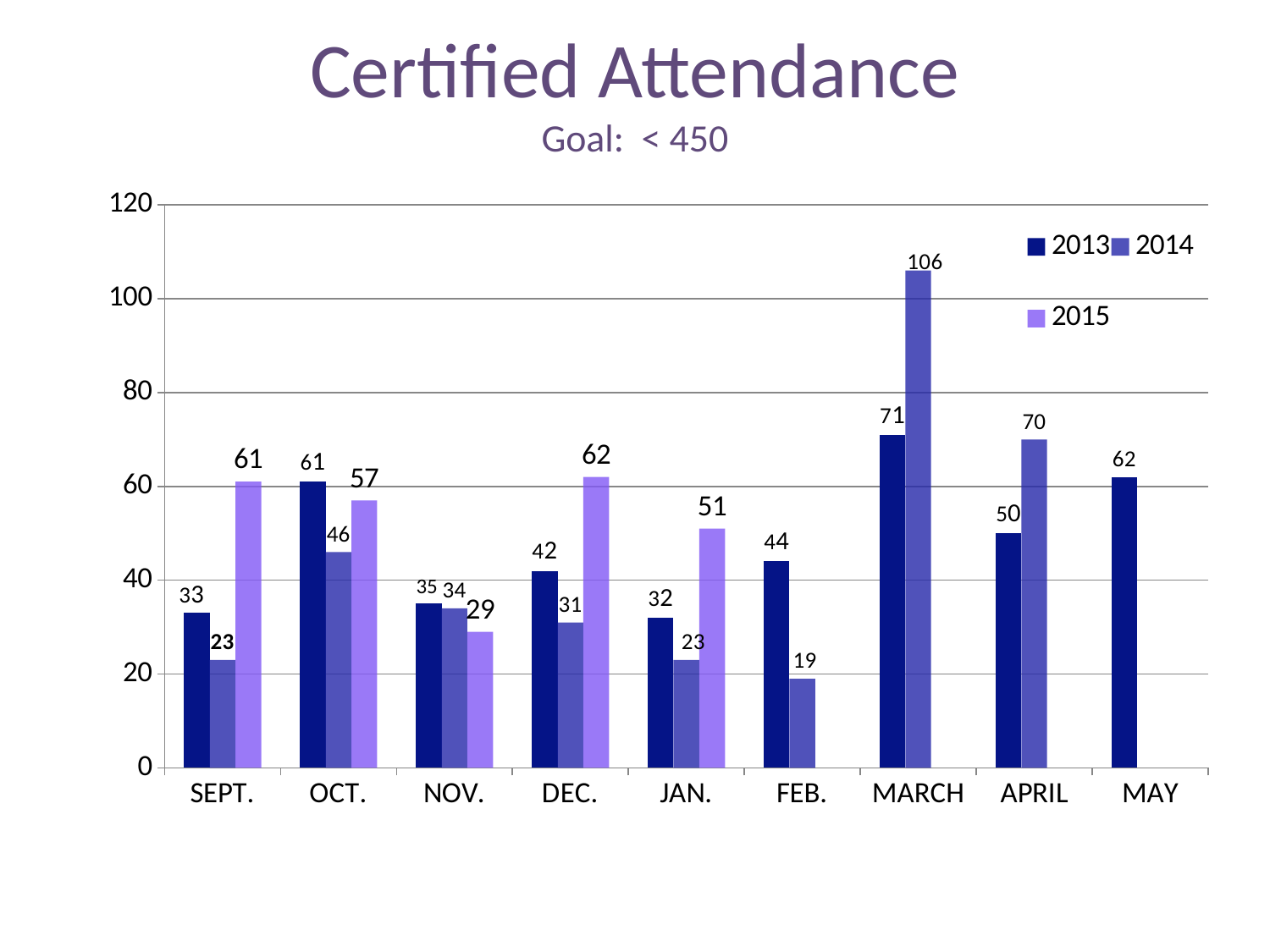
Is the 2014 value for MARCH greater or less than 100? greater Which is larger for OCT., the 2013 value or the 2015 value? 2013 What is the title of the chart? Certified Attendance Which month has the lowest 2014 value? FEB. How many months are shown on the x axis? 9 How many series does the legend list? 3 What kind of chart is shown? bar chart What is the 2013 value for FEB.? 44 What is the 2015 value for DEC.? 62 What is the difference between the 2014 and 2013 values for MARCH? 35 Which month has the highest 2014 value? MARCH What is the 2014 value for MARCH? 106